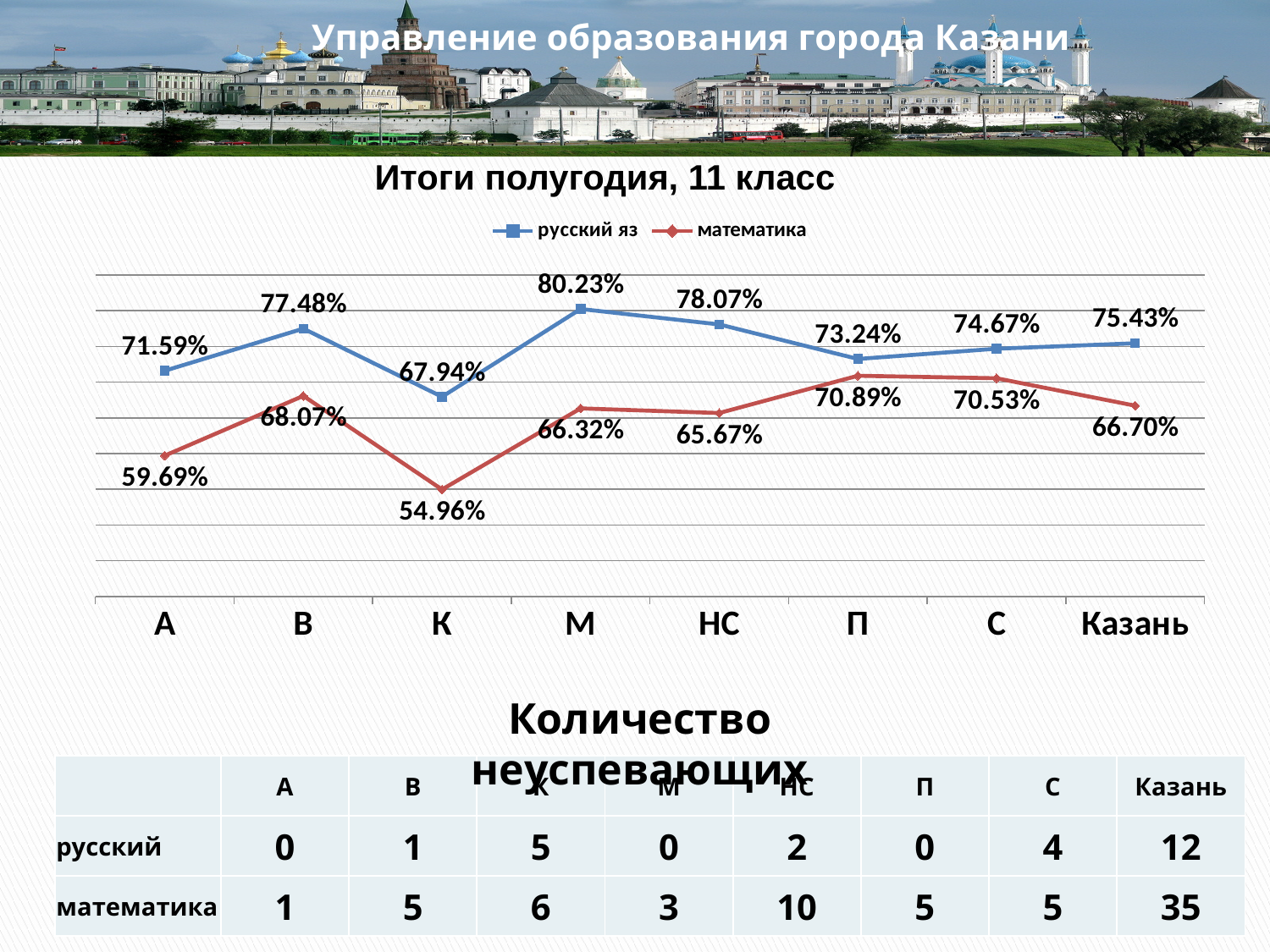
What is the value for 'математика' at Казань? 66.70% What type of chart is shown under the title 'Итоги полугодия, 11 класс'? line chart Which is larger at category П: the value for 'русский яз' or for 'математика'? русский яз What is the value for 'русский яз' at category М? 80.23% How many series does the legend of the chart list? 2 How many categories are shown on the x axis of the chart? 8 Does the 'математика' line rise or fall from category С to Казань? fall What is the value for 'математика' at category К? 54.96% Which category has the highest value for 'русский яз'? М Which colour is used for the 'математика' series in the chart? red What is the difference between 'русский яз' and 'математика' at category А? 11.90% Which category has the lowest value for 'математика'? К